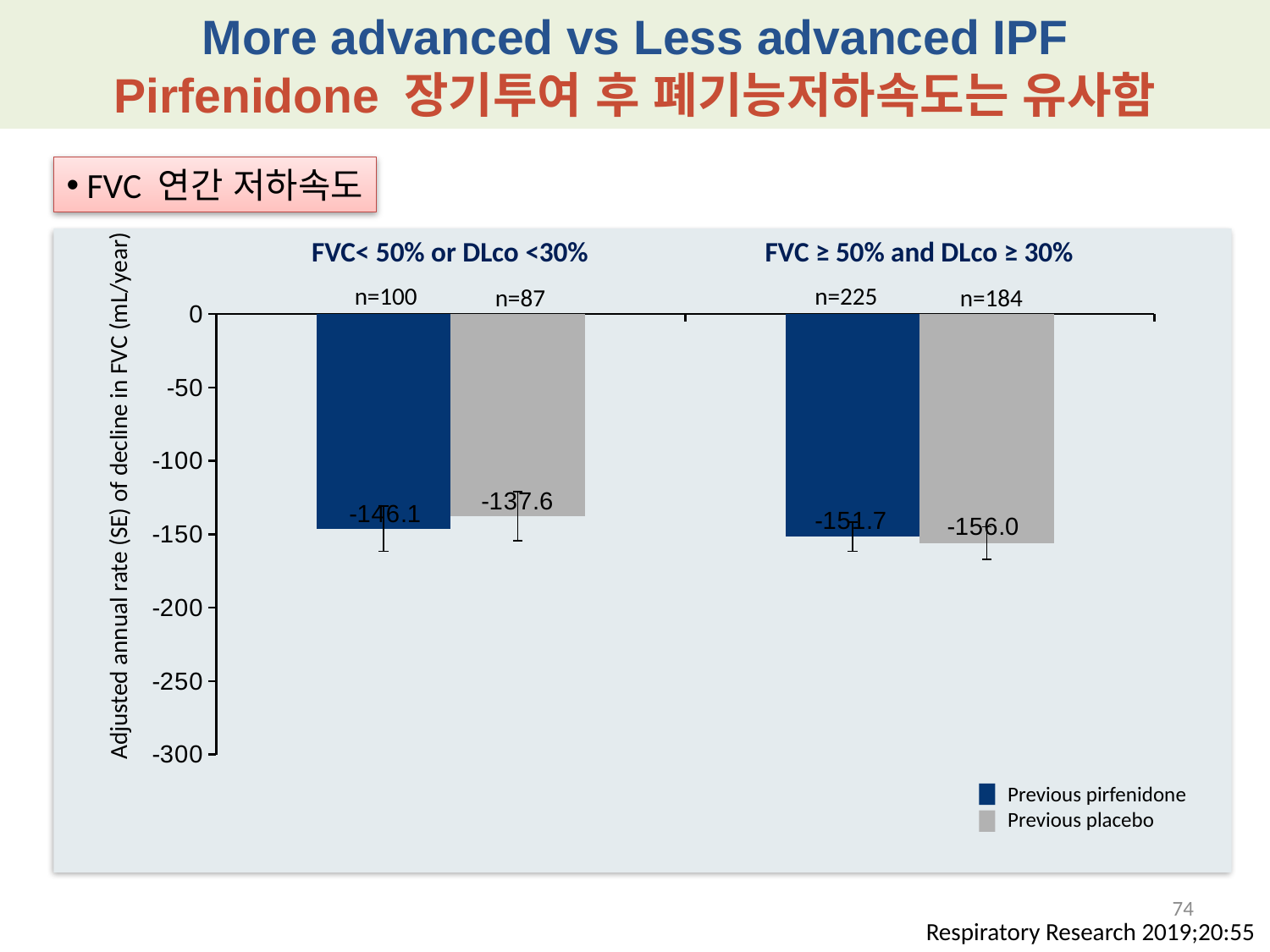
What is the value for Previous placebo in the FVC ≥ 50% and DLco ≥ 30% group? -156.0 Is the Previous placebo value in the FVC< 50% or DLco <30% group greater or less than -150? greater What is the value for Previous placebo in the FVC< 50% or DLco <30% group? -137.6 What is the difference between the Previous placebo values in the two groups (-137.6 and -156.0)? 18.4 What type of chart is shown on the slide? bar chart How many series does the legend list? 2 What is the value for Previous pirfenidone in the FVC< 50% or DLco <30% group? -146.1 What is the value for Previous pirfenidone in the FVC ≥ 50% and DLco ≥ 30% group? -151.7 How many bars are plotted in the chart? 4 Which bar shows the smallest decline (value closest to zero)? Previous placebo in the FVC< 50% or DLco <30% group Which bar shows the largest decline (most negative value)? Previous placebo in the FVC ≥ 50% and DLco ≥ 30% group What is the sample size (n) shown above the Previous pirfenidone bar in the FVC ≥ 50% and DLco ≥ 30% group? n=225